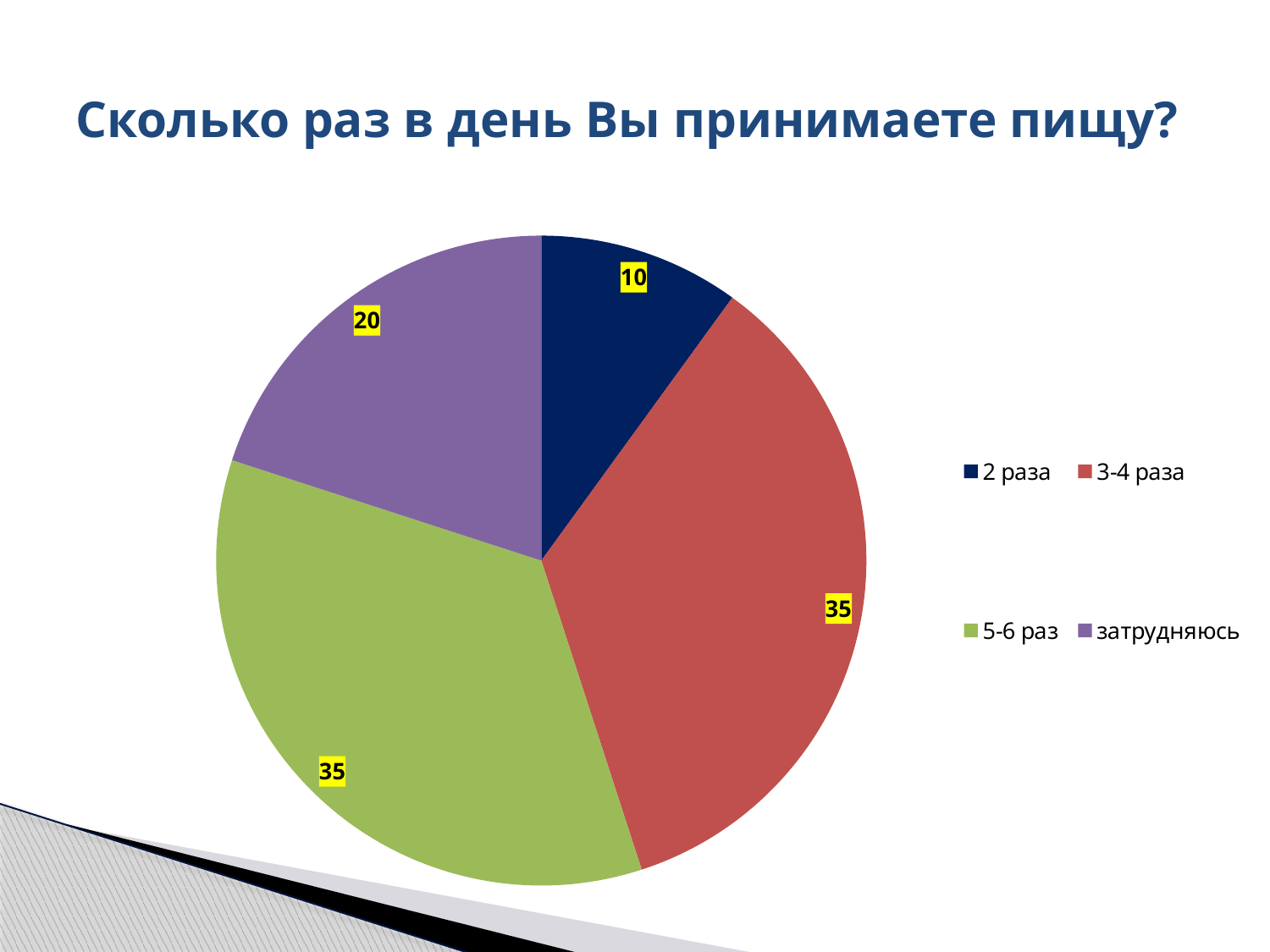
How many entries does the legend list? 4 What is the value for the "2 раза" slice? 10 What is the difference between the values for "затрудняюсь" and "2 раза"? 10 What is the value for the "3-4 раза" slice? 35 What is the title of the chart on the slide? Сколько раз в день Вы принимаете пищу? Which is larger, the value for "затрудняюсь" or the value for "2 раза"? затрудняюсь Which category has the smallest slice? 2 раза What is the value for the "5-6 раз" slice? 35 What is the value for the "затрудняюсь" slice? 20 What share of the pie does the "2 раза" slice represent? 10% What kind of chart is shown on the slide? pie chart How many slices does the pie chart have? 4